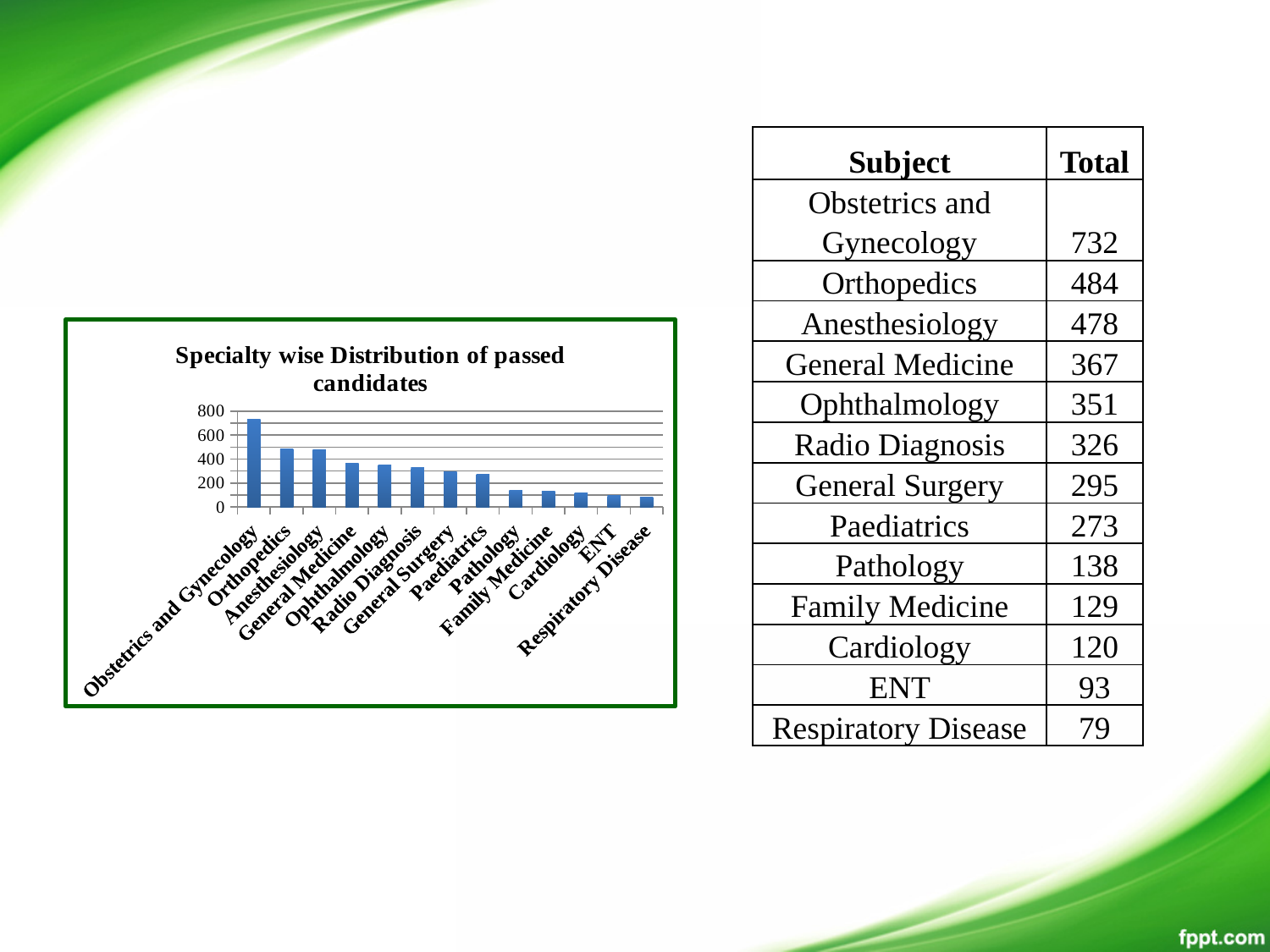
Which specialty has the lowest number of passed candidates? Respiratory Disease What is the title of the chart? Specialty wise Distribution of passed candidates What is the total number of passed candidates for Orthopedics? 484 Do the bar values rise or fall from left to right along the x axis? fall Is the value for ENT greater or less than 200? less What kind of chart is shown on the slide? bar chart What is the total number of passed candidates for Pathology? 138 Which specialty has the highest number of passed candidates? Obstetrics and Gynecology Which has more passed candidates, General Medicine or Cardiology? General Medicine Is the value for Obstetrics and Gynecology greater or less than 600? greater What is the difference between the totals for Obstetrics and Gynecology and Orthopedics? 248 How many specialties are plotted in the chart? 13